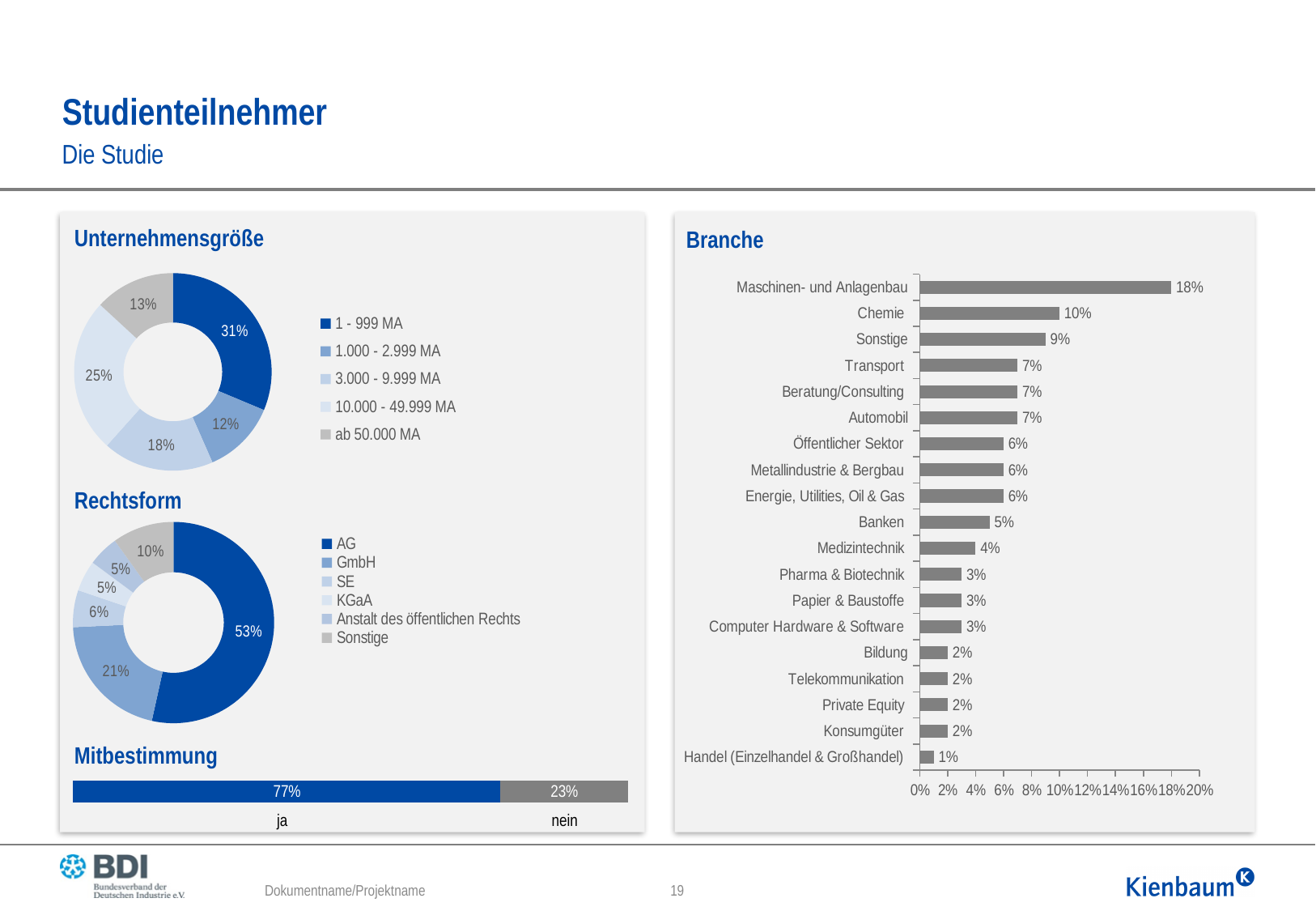
In the Unternehmensgröße chart, which company size category has the smallest share? 1.000 - 2.999 MA How many entries does the legend of the Unternehmensgröße chart list? 5 How many industries are listed in the Branche chart? 19 In the Branche chart, which industry has the highest share? Maschinen- und Anlagenbau In the Unternehmensgröße chart, what share of participants have 1 - 999 MA? 31% In the Rechtsform chart, which is larger, the share for SE or the share for Sonstige? Sonstige In the Branche chart, which industry has the lowest share? Handel (Einzelhandel & Großhandel) In the Rechtsform chart, what share of participants are AG? 53% In the Branche chart, what is the value for Chemie? 10% In the Mitbestimmung chart, what percentage answered 'ja'? 77% In the Rechtsform chart, what is the difference between the AG share and the GmbH share? 32 percentage points What kind of chart is the Branche chart? Bar chart